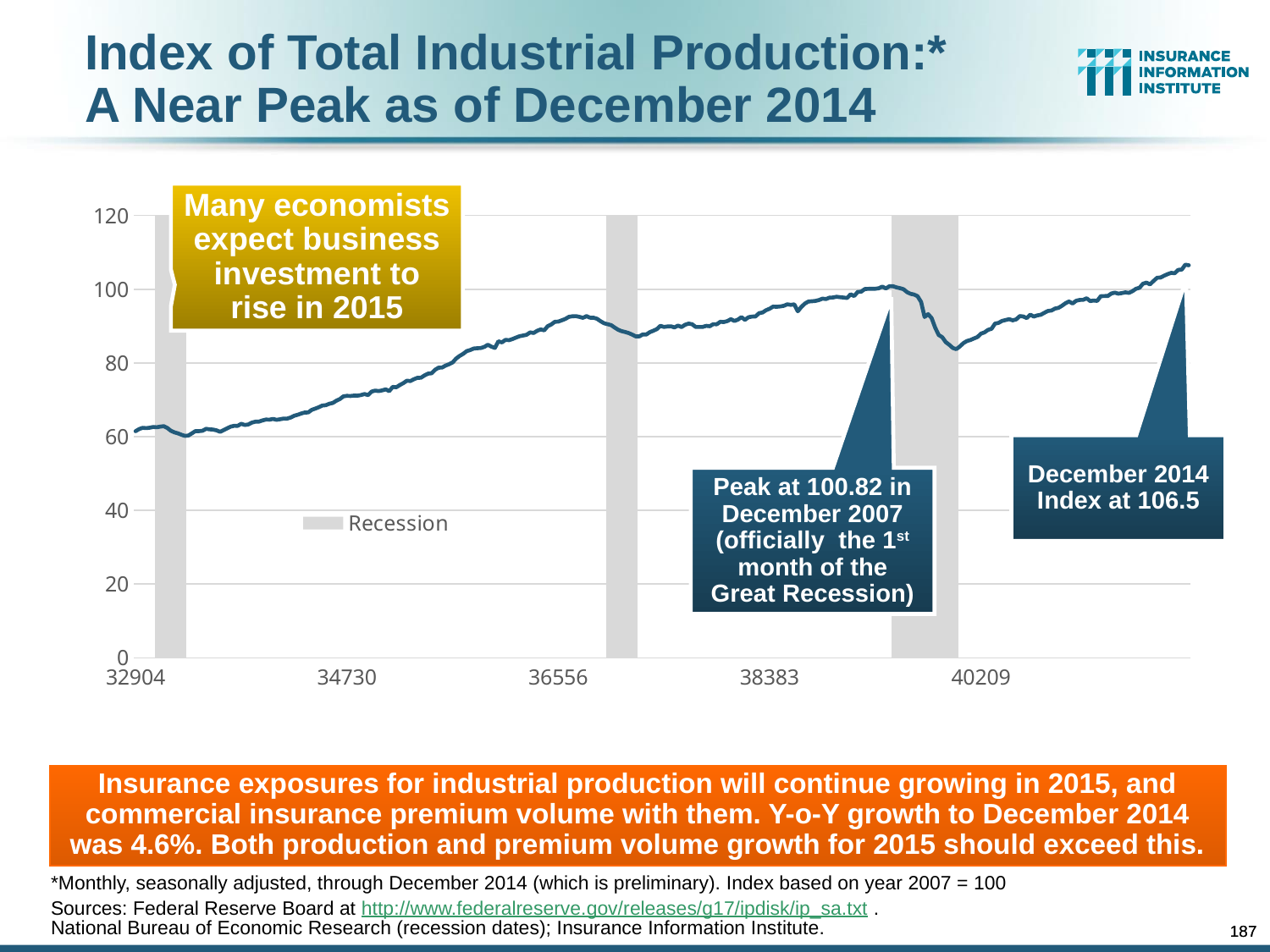
What kind of chart is shown on the slide? line chart What was the Index of Total Industrial Production in December 2014, according to the callout? 106.5 Over the whole period shown, does the index generally rise or fall from left to right? rise Is the index value at the x-axis tick 40209 greater or less than 100? less How many shaded recession bands are shown on the chart? 3 What was the peak value of the index in December 2007, according to the callout? 100.82 Is the index value at the x-axis tick 36556 greater or less than 80? greater By how much does the December 2014 index value exceed the December 2007 peak? 5.68 Is the index value at the far left of the chart (at 32904) greater or less than 80? less What do the gray shaded bands on the chart represent, according to the legend? Recession Which is higher: the index in December 2007 or the index in December 2014? December 2014 What is the highest value labeled on the vertical axis? 120